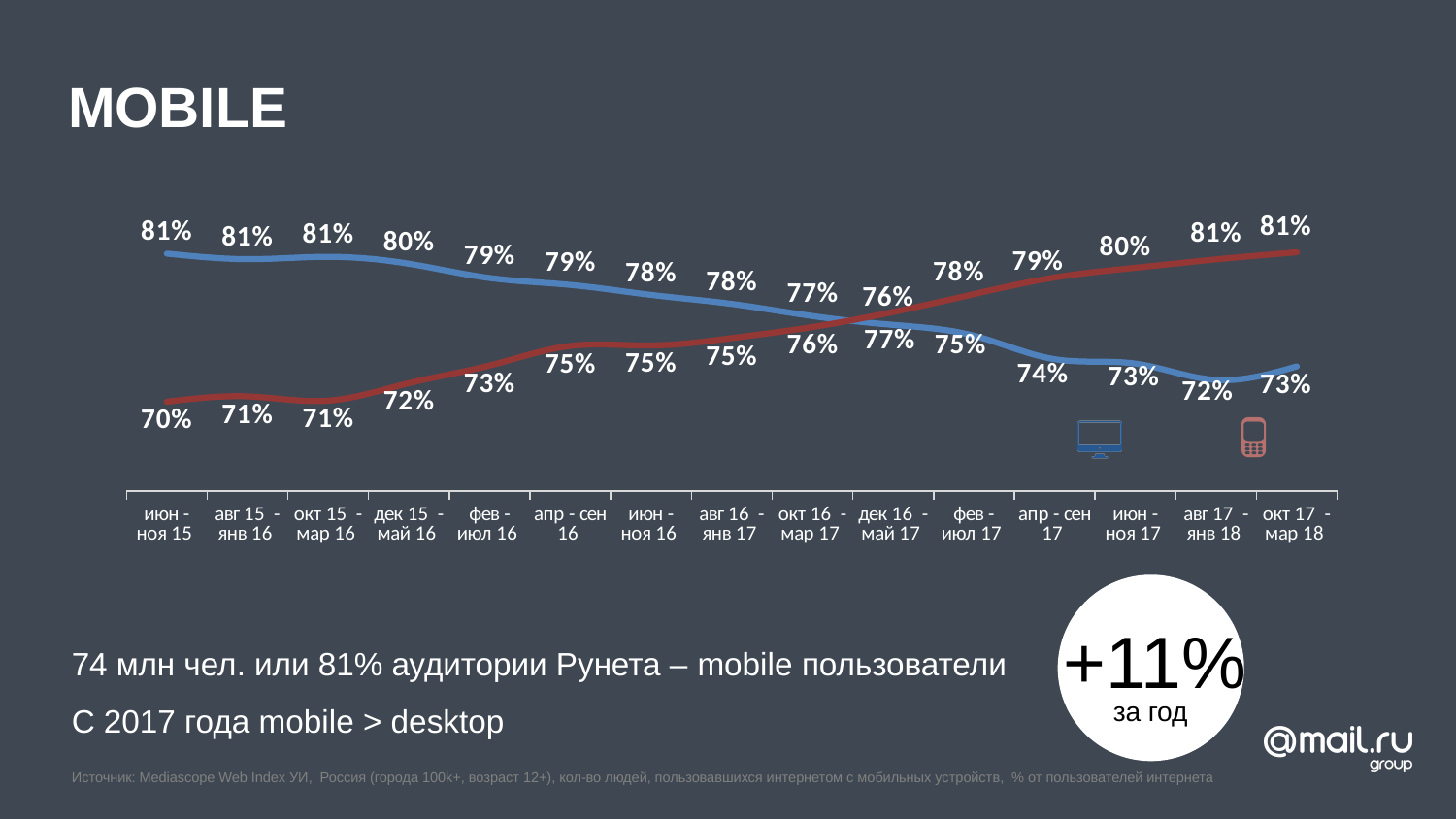
What kind of chart is shown on the slide? line chart In which period is the red line at its lowest value? июн - ноя 15 Does the red line rise or fall from left to right across the periods? rises What is the value of the red line for the period "апр - сен 16"? 75% How many time periods are plotted along the x axis? 15 What is the difference between the blue line and the red line in the period "июн - ноя 15"? 11 percentage points How many lines are plotted on the chart? 2 What is the value of the blue line for the period "окт 17 - мар 18"? 73% What is the value of the red line for the period "июн - ноя 15"? 70% What is the title of the slide containing the chart? MOBILE In which period is the blue line at its lowest value? авг 17 - янв 18 Which line has the higher value in the period "фев - июл 17", the red line or the blue line? the red line